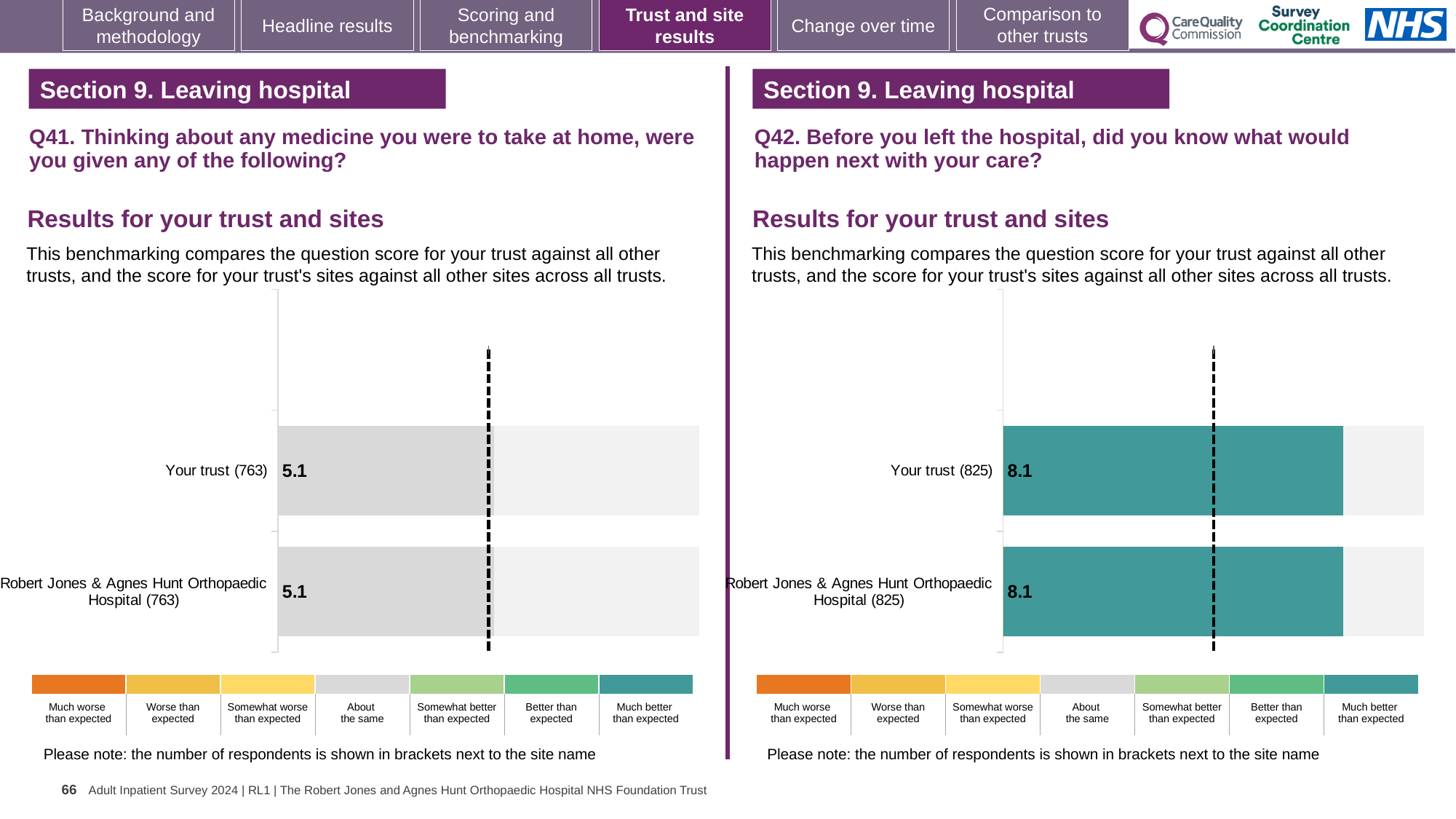
In the Q41 chart on the left, how many respondents are shown in brackets for Your trust? 763 In the Q42 chart on the right, what is the score for Your trust? 8.1 How many bars are plotted in the Q41 chart on the left? 2 In the Q42 chart on the right, how many respondents are shown in brackets for Robert Jones & Agnes Hunt Orthopaedic Hospital? 825 In the Q41 chart on the left, what is the difference between the score for Your trust and the score for Robert Jones & Agnes Hunt Orthopaedic Hospital? 0.0 Is the score for Your trust in the Q42 chart on the right larger or smaller than the score for Your trust in the Q41 chart on the left? Larger In the Q41 chart on the left, what is the score for Robert Jones & Agnes Hunt Orthopaedic Hospital? 5.1 In the Q41 chart on the left, what is the score for Your trust? 5.1 What kind of chart is the Q42 chart on the right? Bar chart In the Q42 chart on the right, what is the score for Robert Jones & Agnes Hunt Orthopaedic Hospital? 8.1 In the Q42 chart on the right, what is the difference between the score for Your trust and the score for Robert Jones & Agnes Hunt Orthopaedic Hospital? 0.0 How many bars are plotted in the Q42 chart on the right? 2